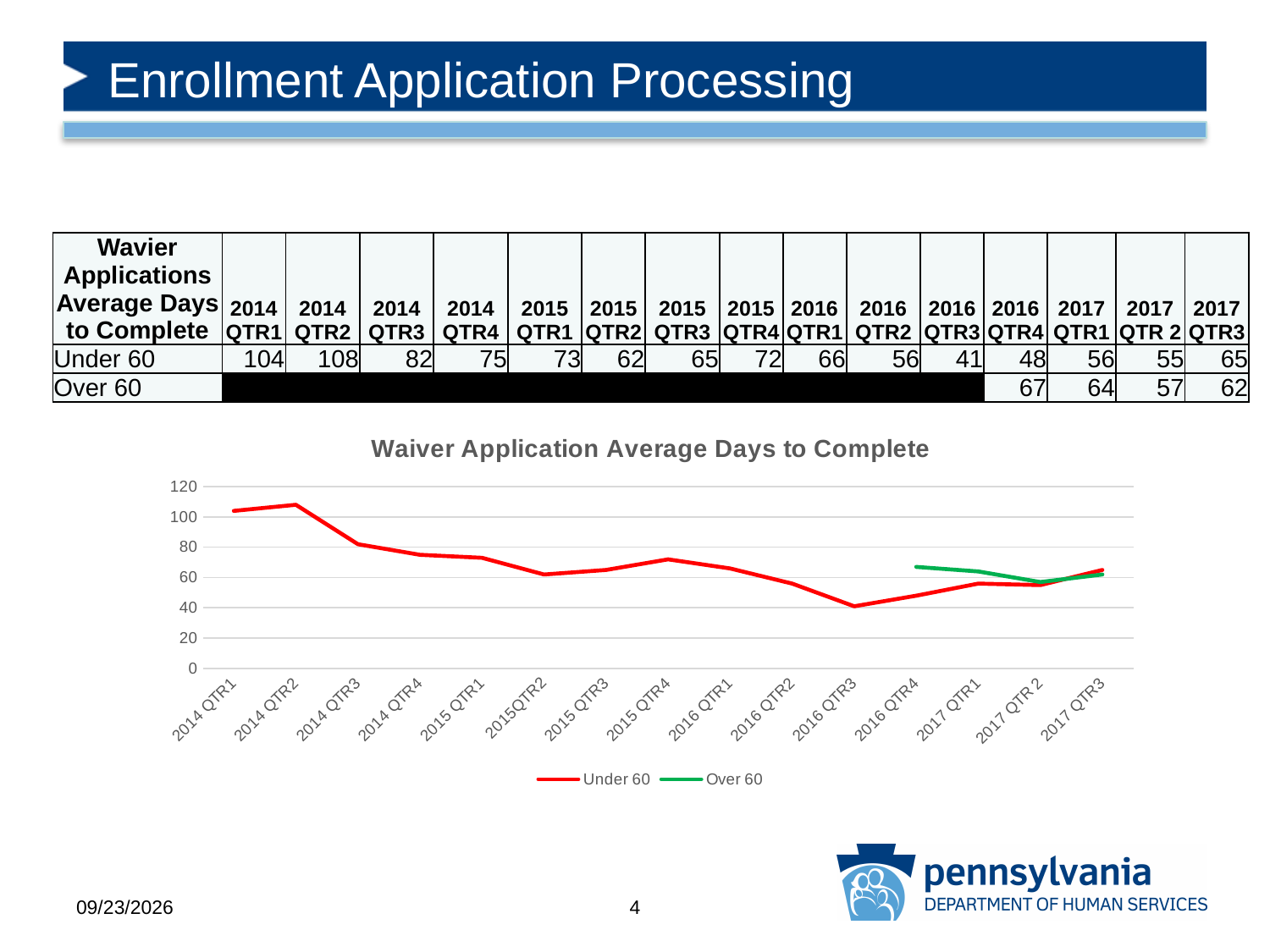
What is the Under 60 value for 2014 QTR2? 108 Does the Under 60 series generally rise or fall from 2014 QTR1 to 2016 QTR3? fall What is the Under 60 value for 2016 QTR3? 41 Which series has the larger value in 2017 QTR3, Under 60 or Over 60? Under 60 What is the Over 60 value for 2016 QTR4? 67 In which quarter is the Under 60 series highest? 2014 QTR2 What is the difference between the Under 60 values for 2014 QTR2 and 2014 QTR1? 4 What type of chart is shown on the slide? line chart In which quarter is the Under 60 series lowest? 2016 QTR3 Is the Under 60 value for 2014 QTR1 greater or less than 100? greater How many series does the chart legend list? 2 How many quarters are plotted along the x axis of the chart? 15